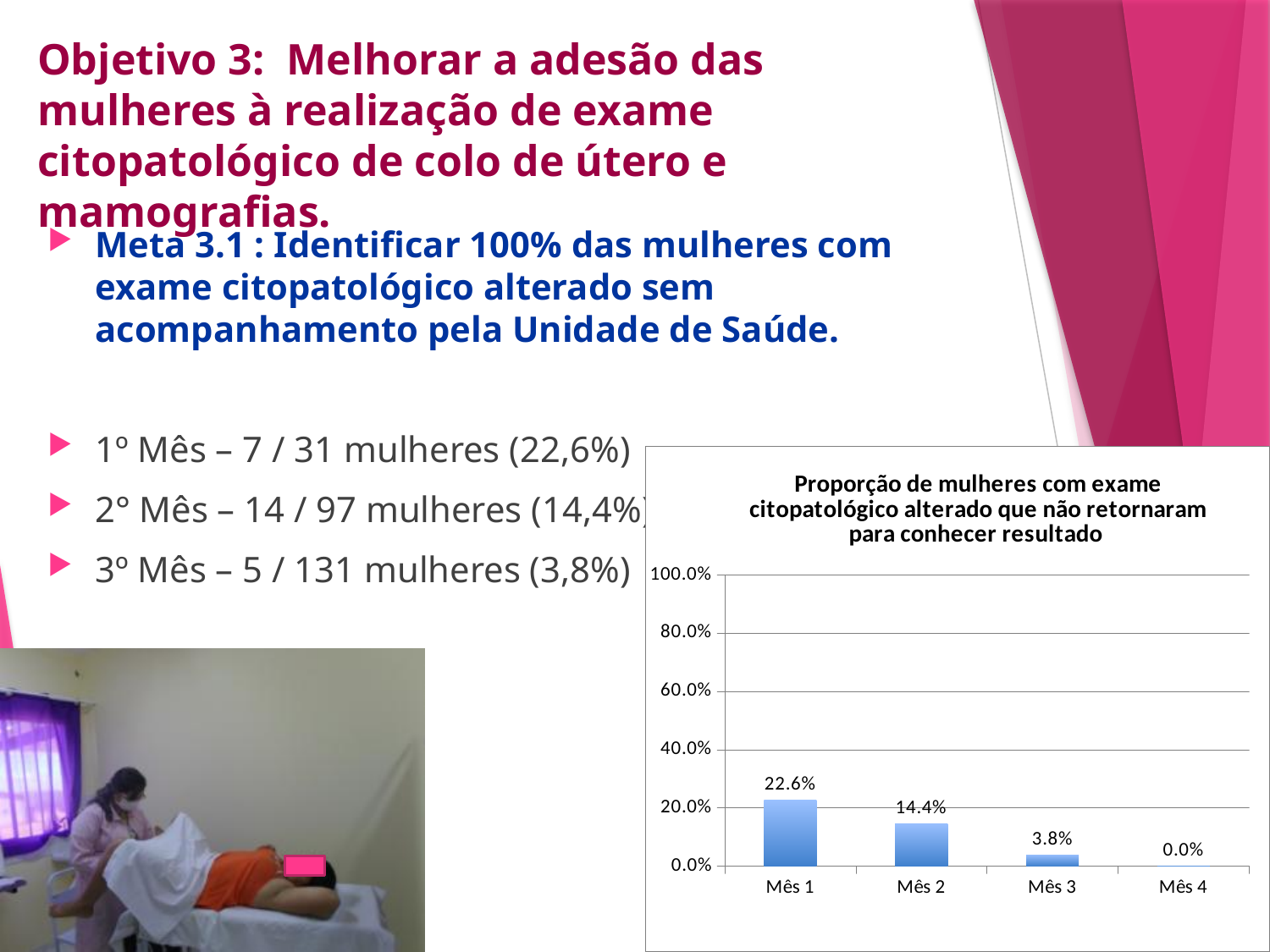
Which month has the lowest value in the chart? Mês 4 What is the value for Mês 1 in the chart? 22.6% How many months are shown on the x axis of the chart? 4 Is the value for Mês 1 greater or less than 20.0%? greater What kind of chart is shown on the slide? bar chart What is the value for Mês 2 in the chart? 14.4% What is the value for Mês 3 in the chart? 3.8% Which month has the highest value in the chart? Mês 1 Which is larger, the value for Mês 2 or the value for Mês 3? Mês 2 What is the difference between the values for Mês 1 and Mês 2? 8.2% Do the values rise or fall from Mês 1 to Mês 4? fall What is the value for Mês 4 in the chart? 0.0%